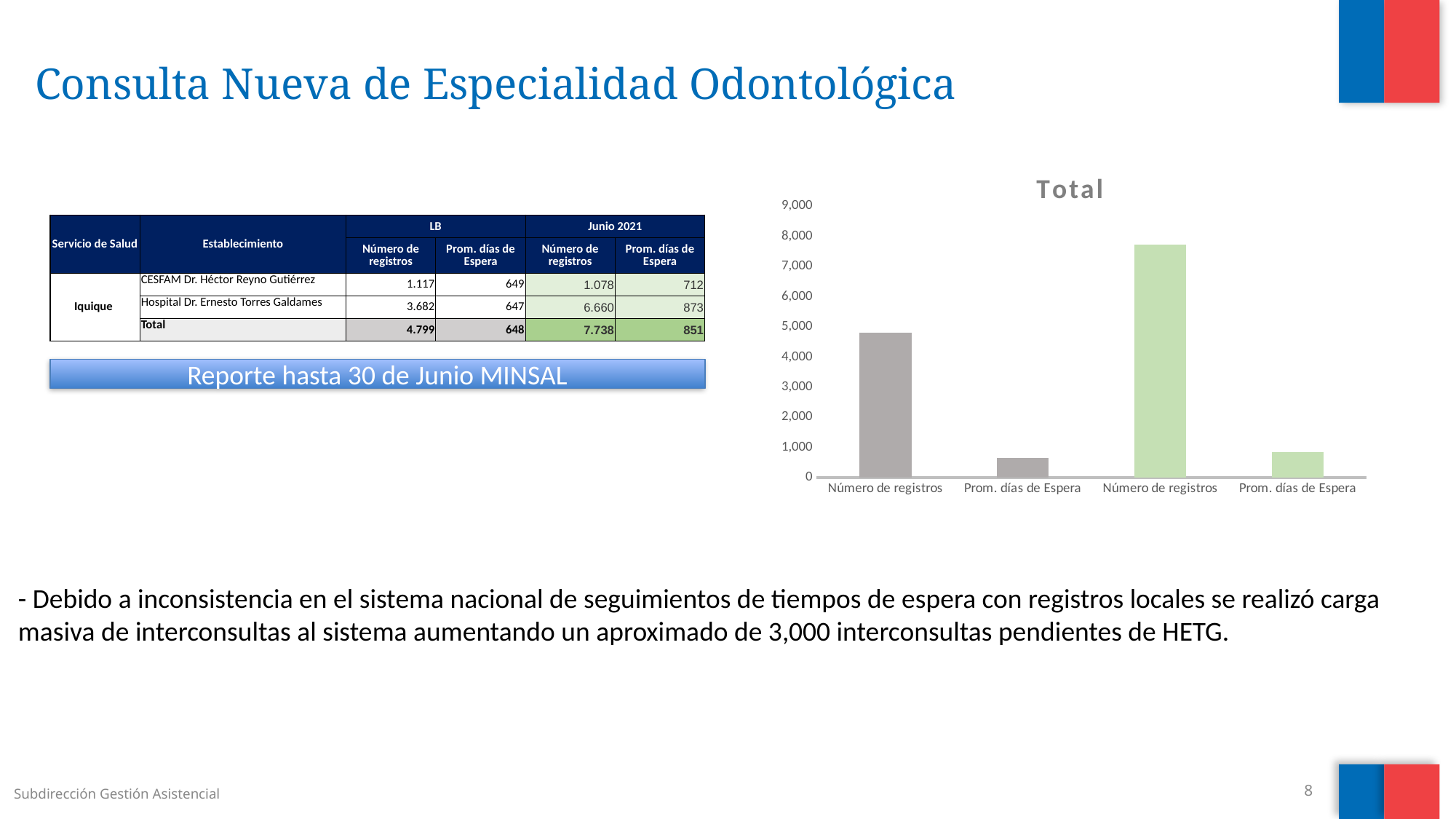
Which is taller: the left-hand Número de registros bar or the right-hand Número de registros bar? The right-hand Número de registros bar Is the value of the first (left-hand) Prom. días de Espera bar greater or less than 1,000? less What is the highest value shown on the chart's vertical axis? 9,000 Which bar in the chart is the shortest? The first (left-hand) Prom. días de Espera bar What kind of chart is shown on the slide? bar chart Is the value of the second (right-hand) Prom. días de Espera bar greater or less than 1,000? less How many bars are plotted in the chart? 4 What is the title of the chart? Total Is the value of the first (left-hand) Número de registros bar greater or less than 5,000? less Which bar in the chart is the tallest? The second (right-hand) Número de registros bar